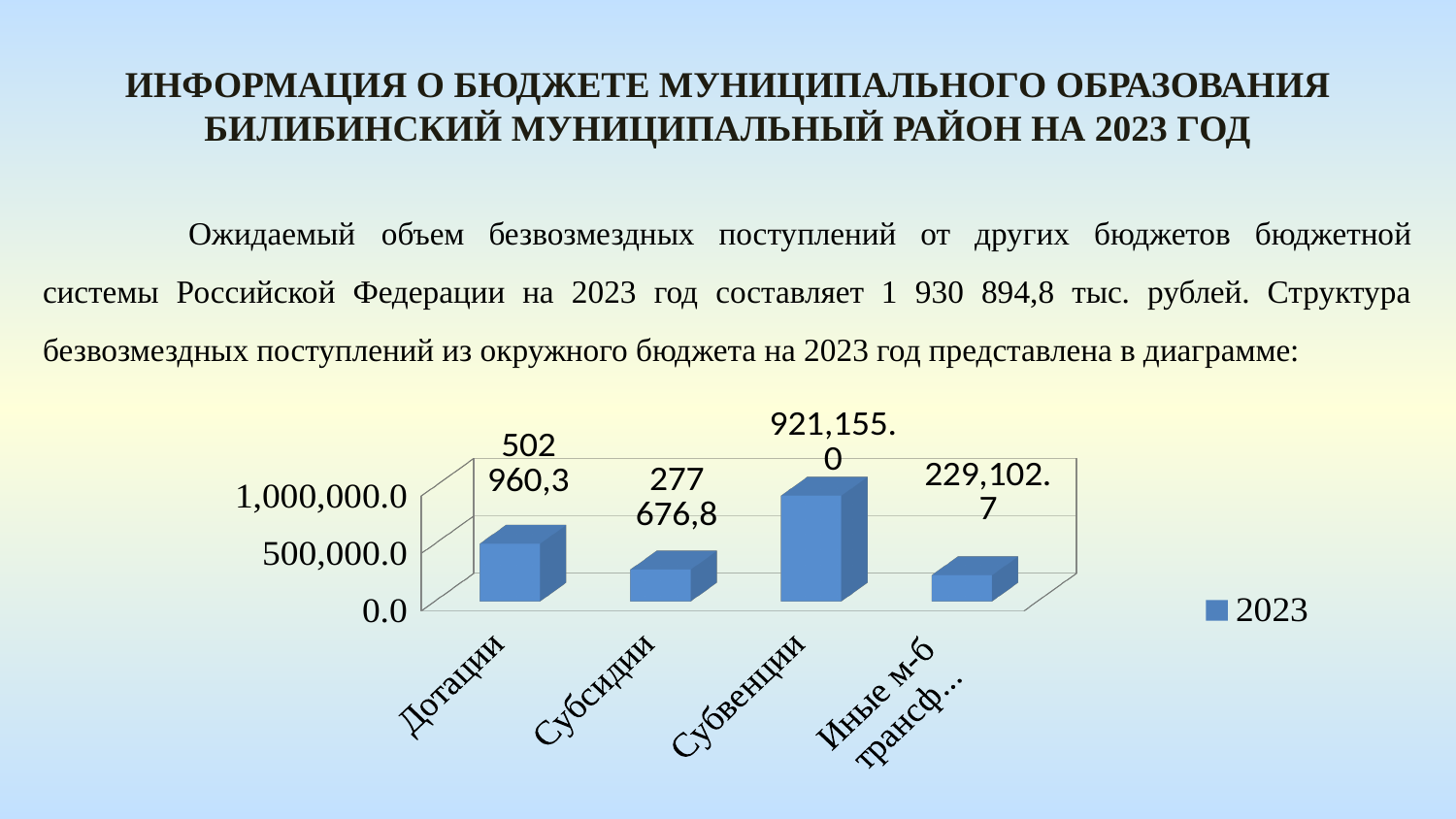
Which category has the highest value? Субвенции What kind of chart is shown on the slide? Bar chart Is the value for Субвенции greater or less than 500,000.0? greater How many categories are shown on the chart? 4 What value is shown for Субсидии? 277 676,8 What value is shown for Дотации? 502 960,3 What value is shown for the fourth category, Иные м-б трансф...? 229,102.7 What value is shown for Субвенции? 921,155.0 Is the value for Субсидии greater or less than 500,000.0? less Which is larger, the value for Дотации or the value for Субсидии? Дотации Which category has the lowest value? Иные м-б трансф... How many series does the legend list? 1